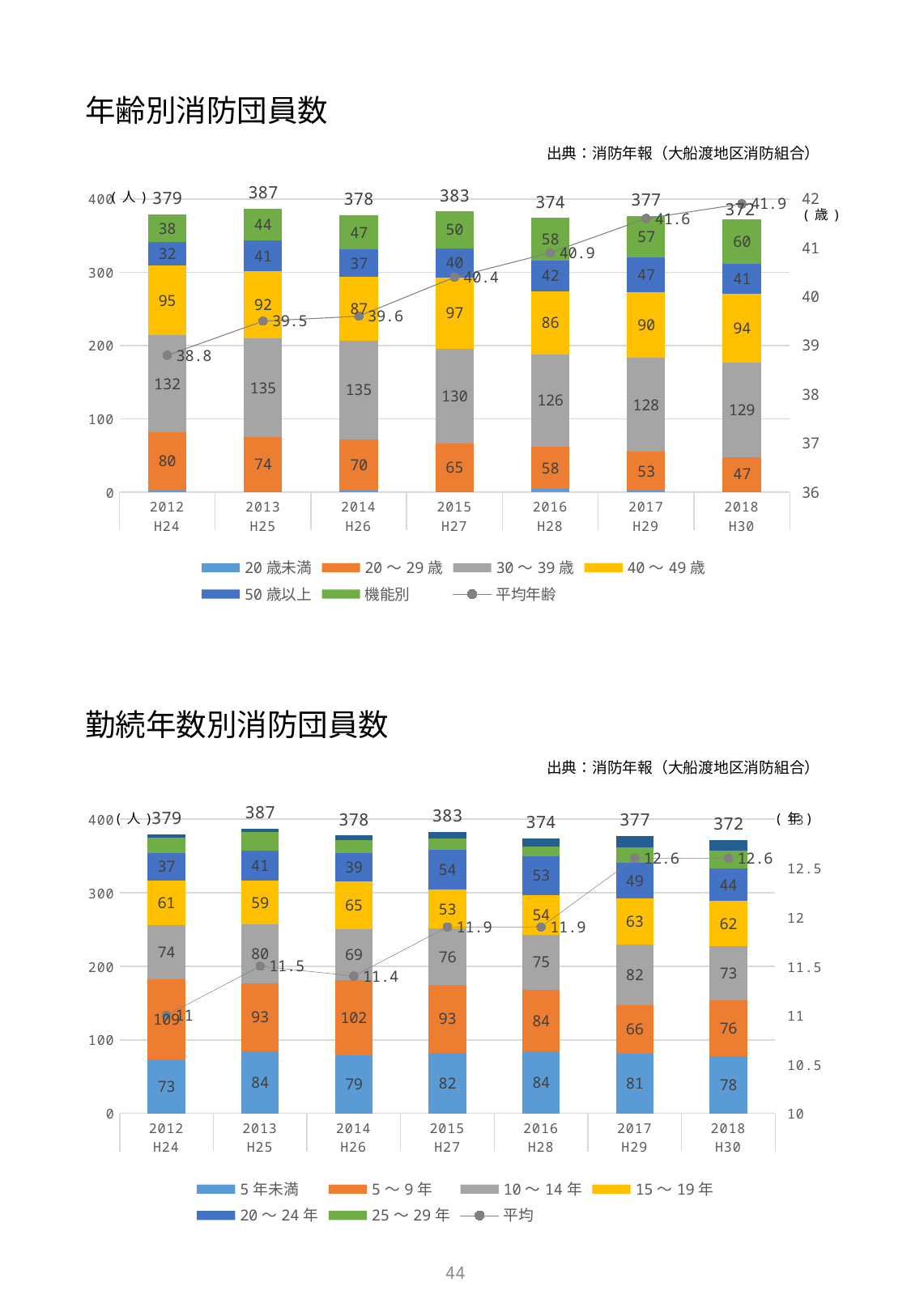
In the 勤続年数別消防団員数 chart, what is the value for 5年未満 in 2013 (H25)? 84 What kind of chart is the 勤続年数別消防団員数 chart? Stacked bar chart with a line How many years are shown on the x axis of the 勤続年数別消防団員数 chart? 7 In the 年齢別消防団員数 chart, does the 平均年齢 line rise or fall from 2012 to 2018? rise In the 年齢別消防団員数 chart, which year has the lowest stacked bar total? 2018 (H30) In the 年齢別消防団員数 chart, what is the total of the stacked bar for 2013 (H25)? 387 In the 年齢別消防団員数 chart, what is the difference between the 30～39歳 values for 2012 and 2016? 6 In the 年齢別消防団員数 chart, what is the value for 20～29歳 in 2012 (H24)? 80 In the 勤続年数別消防団員数 chart, which is larger, the 5～9年 value for 2012 or for 2018? 2012 In the 勤続年数別消防団員数 chart, what is the 平均 value for 2014 (H26)? 11.4 In the 年齢別消防団員数 chart, what is the 平均年齢 value for 2018 (H30)? 41.9 How many series does the legend of the 年齢別消防団員数 chart list? 7